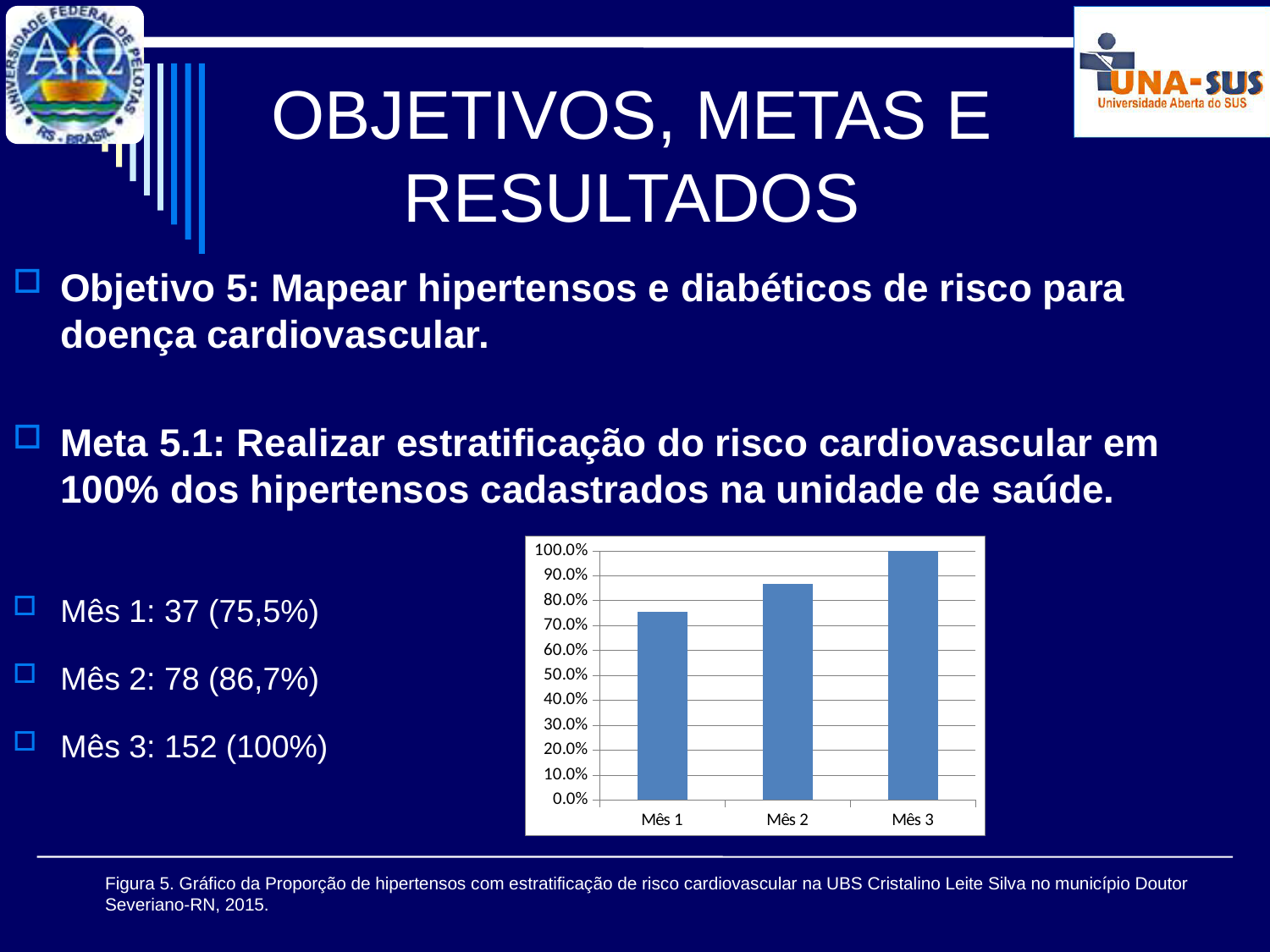
Which month has the lowest bar in the chart? Mês 1 According to the slide, what proportion is reported for Mês 2? 86,7% Which month has the highest bar in the chart? Mês 3 Which is larger, the value for Mês 1 or the value for Mês 2? Mês 2 Is the value for Mês 1 greater or less than 80.0%? less Is the value for Mês 2 greater or less than 80.0%? greater What kind of chart is shown on the slide? bar chart Do the values rise or fall from Mês 1 to Mês 3? rise What is the value for Mês 3 in the chart? 100.0% According to the slide, what proportion is reported for Mês 1? 75,5% What is the highest tick value shown on the y axis of the chart? 100.0% How many categories are plotted on the x axis of the chart? 3